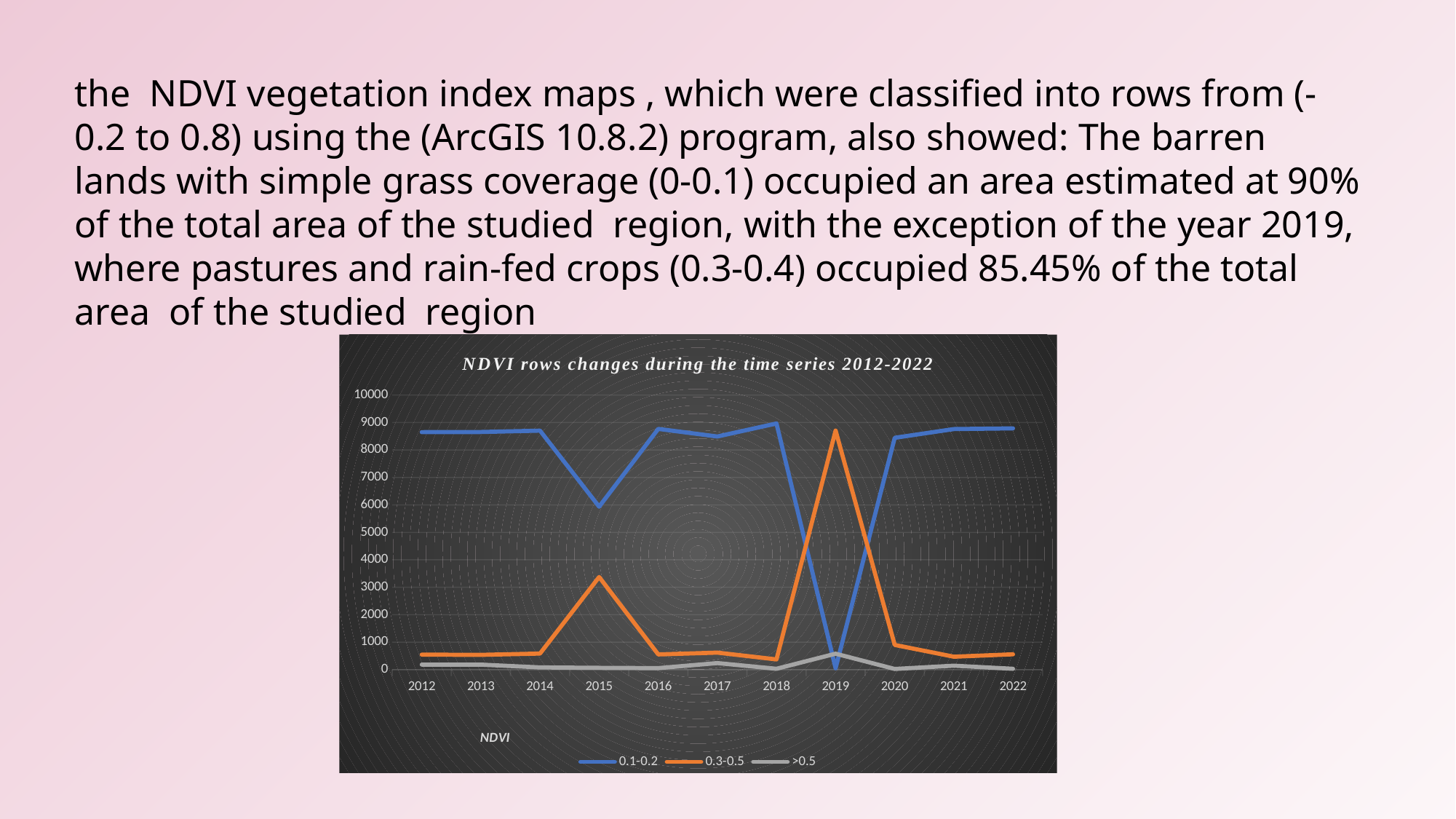
Which series is drawn in orange in the chart? 0.3-0.5 Is the value for the 0.1-0.2 series in 2015 greater or less than 5000? greater In 2019, which series has the larger value, 0.1-0.2 or 0.3-0.5? 0.3-0.5 How many series does the legend of the chart list? 3 Does the 0.1-0.2 series rise or fall from 2019 to 2020? rise What kind of chart is shown on the slide? line chart In which year does the 0.3-0.5 series reach its highest value? 2019 Is the value for the 0.3-0.5 series in 2019 greater or less than 8000? greater What is the title of the chart? NDVI rows changes during the time series 2012-2022 How many years are plotted along the x axis of the chart? 11 Is the value for the 0.3-0.5 series in 2015 greater or less than 2000? greater In which year does the 0.1-0.2 series reach its lowest value? 2019